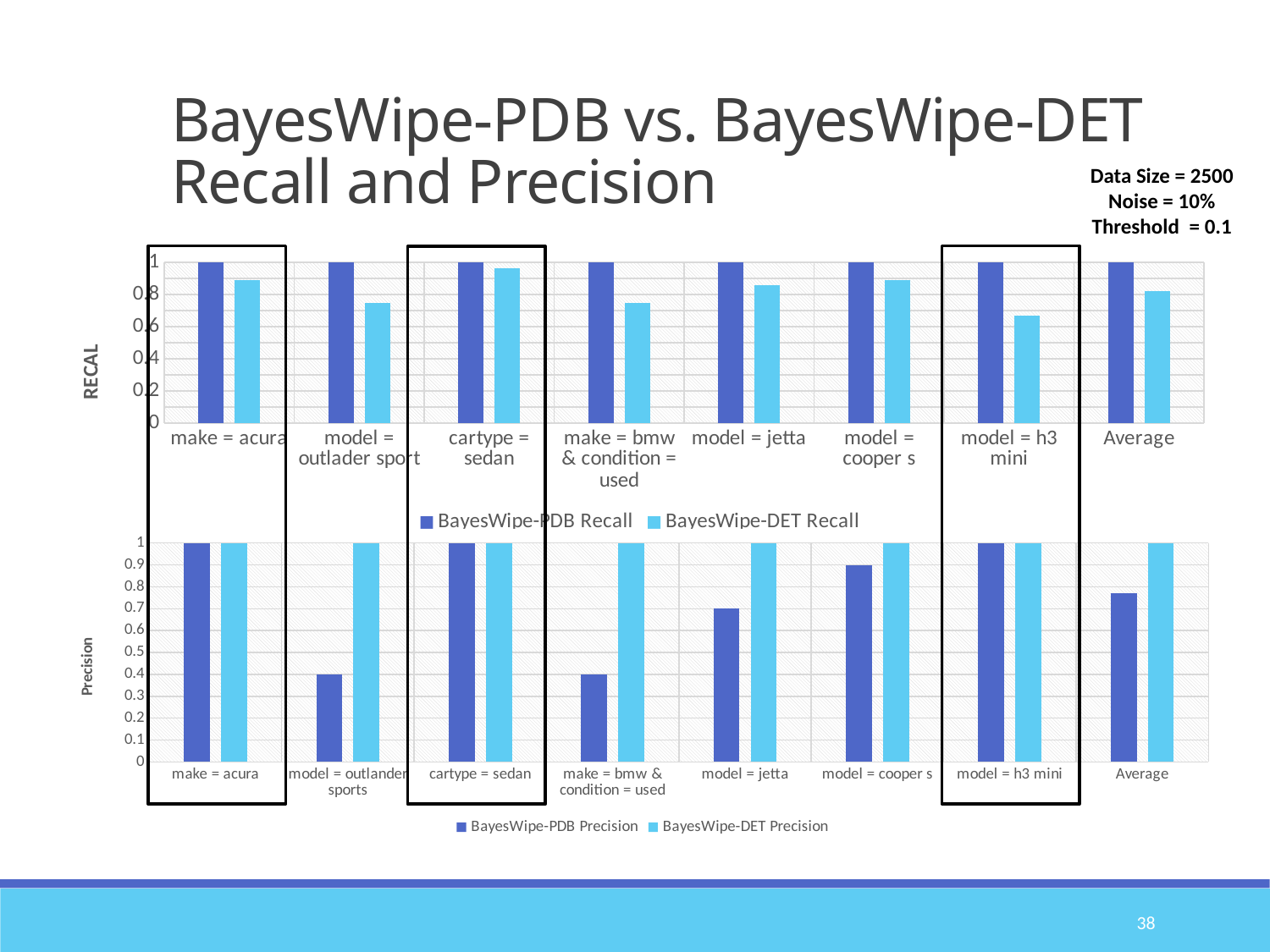
What are the two legend entries of the Precision chart? BayesWipe-PDB Precision and BayesWipe-DET Precision In the Recall chart, how many series does the legend list? 2 In the Recall chart, what is the BayesWipe-PDB Recall value for make = acura? 1 What kind of chart is the Recall chart at the top of the slide? bar chart In the Precision chart, what is the difference between the BayesWipe-DET Precision and BayesWipe-PDB Precision values for model = outlander sports? 0.6 In the Recall chart, how many categories are shown on the x axis? 8 In the Recall chart, which category has the highest BayesWipe-DET Recall? cartype = sedan In the Precision chart, which series has the larger value for make = bmw & condition = used? BayesWipe-DET Precision In the Precision chart, is the BayesWipe-PDB Precision value for model = jetta greater or less than 0.5? greater In the Precision chart, what is the BayesWipe-PDB Precision value for model = outlander sports? 0.4 In the Recall chart, is the BayesWipe-DET Recall value for model = h3 mini greater or less than 0.8? less In the Precision chart, what is the BayesWipe-PDB Precision value for model = cooper s? 0.9